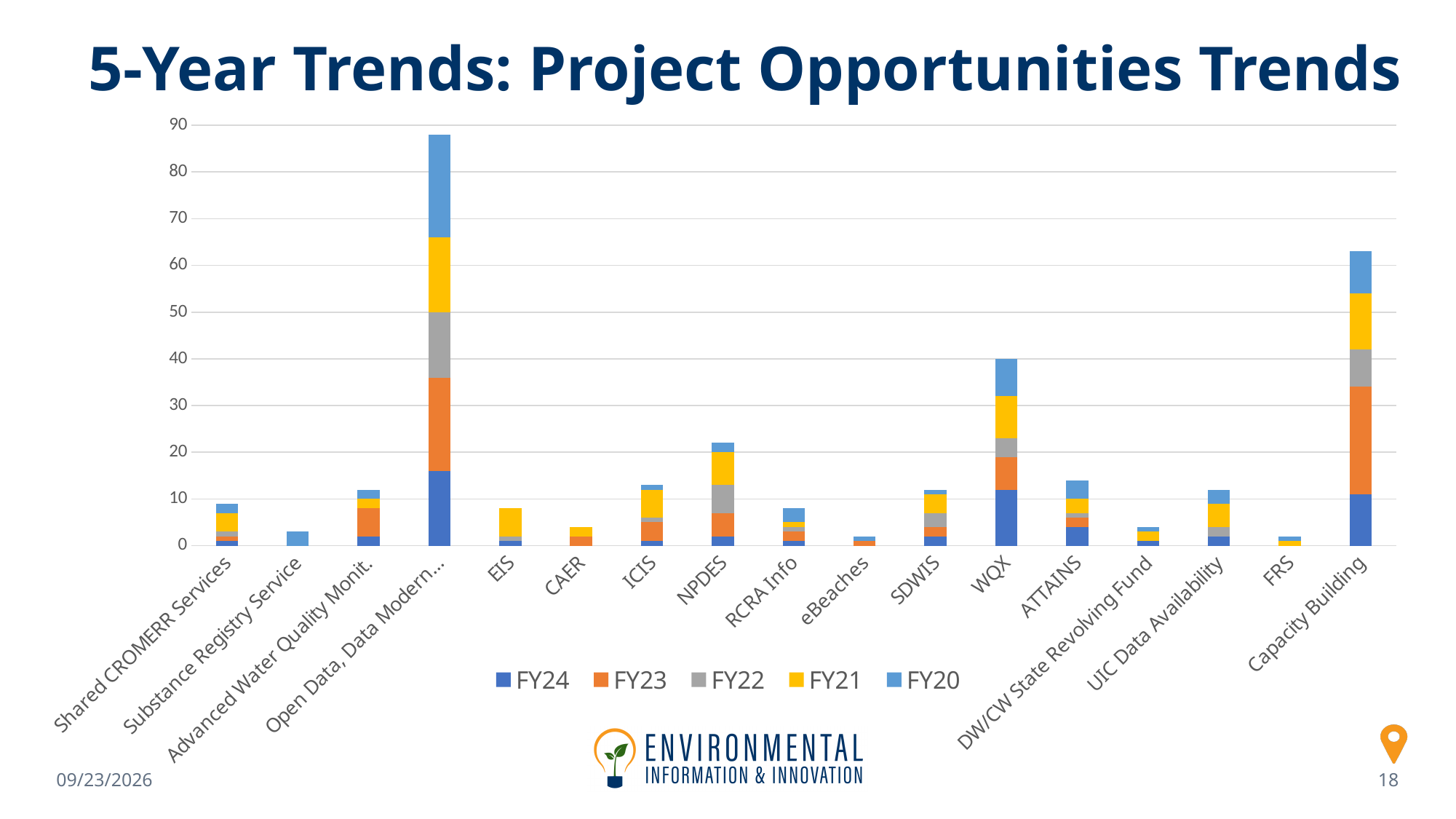
What kind of chart is shown on the slide? Stacked bar chart Which category has the tallest stacked bar? Open Data, Data Modern... Is the total stacked value for Capacity Building greater or less than 50? greater How many series does the legend list? 5 How many categories are shown along the x axis? 17 Is the total stacked value for ICIS greater or less than 20? less Which has the larger total stacked bar, NPDES or ICIS? NPDES Is the total stacked value for Open Data, Data Modern... greater or less than 80? greater What is the title of the chart? 5-Year Trends: Project Opportunities Trends Which has the larger total stacked bar, Capacity Building or WQX? Capacity Building Which fiscal year series is shown in orange in the legend? FY23